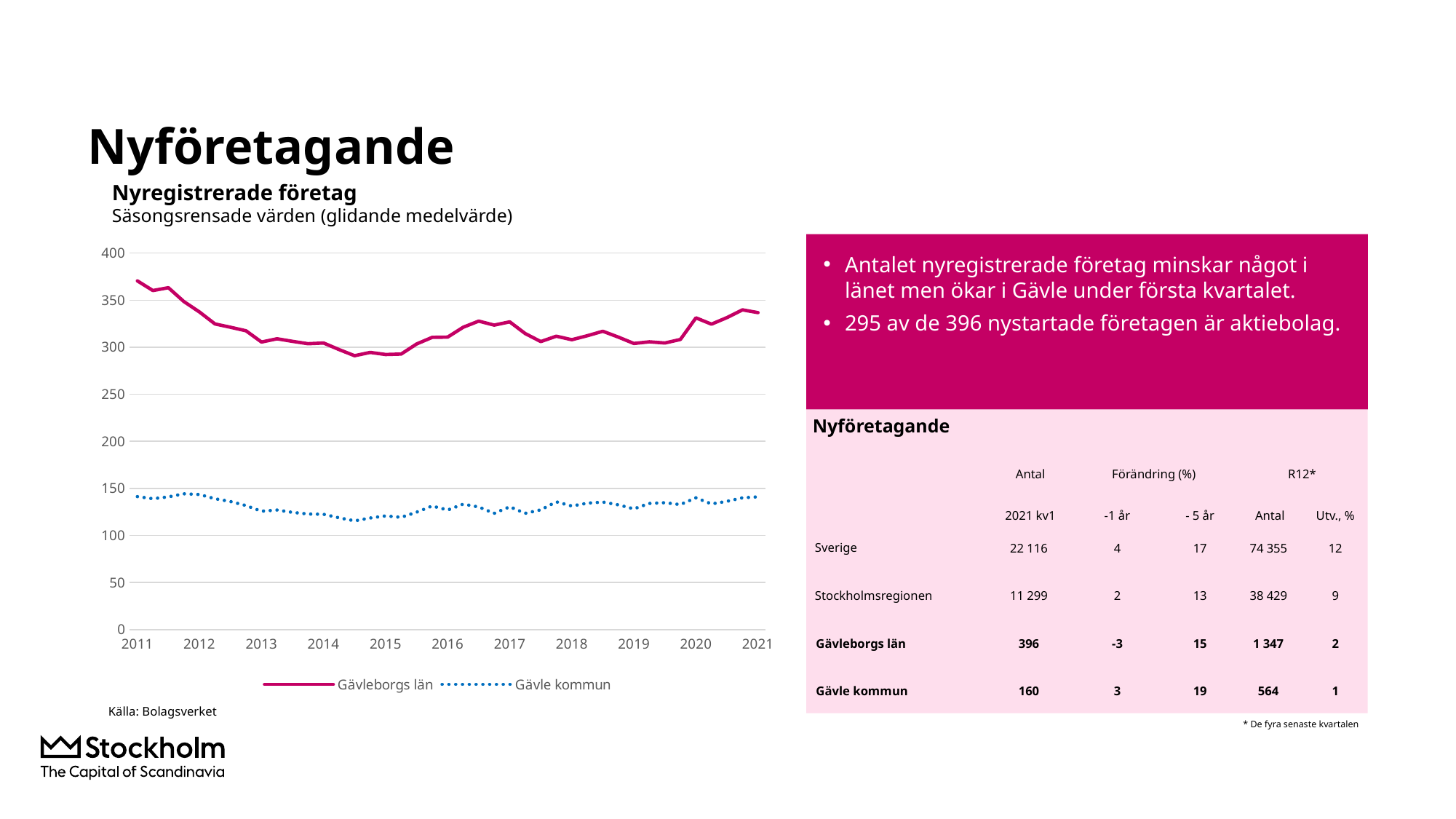
How many year labels are shown on the x axis? 11 Does the Gävleborgs län line rise or fall between 2011 and 2014? Fall Which series has higher values throughout the chart, Gävleborgs län or Gävle kommun? Gävleborgs län Is the value for Gävleborgs län at the start of 2011 greater or less than 350? greater How many series does the chart legend list? 2 Is the value for Gävle kommun around 2014–2015 greater or less than 100? greater What is the title of the chart? Nyregistrerade företag Which series is drawn with a dotted line in the chart? Gävle kommun Is the value for Gävle kommun at the start of 2011 greater or less than 150? less What kind of chart is shown on the slide? Line chart